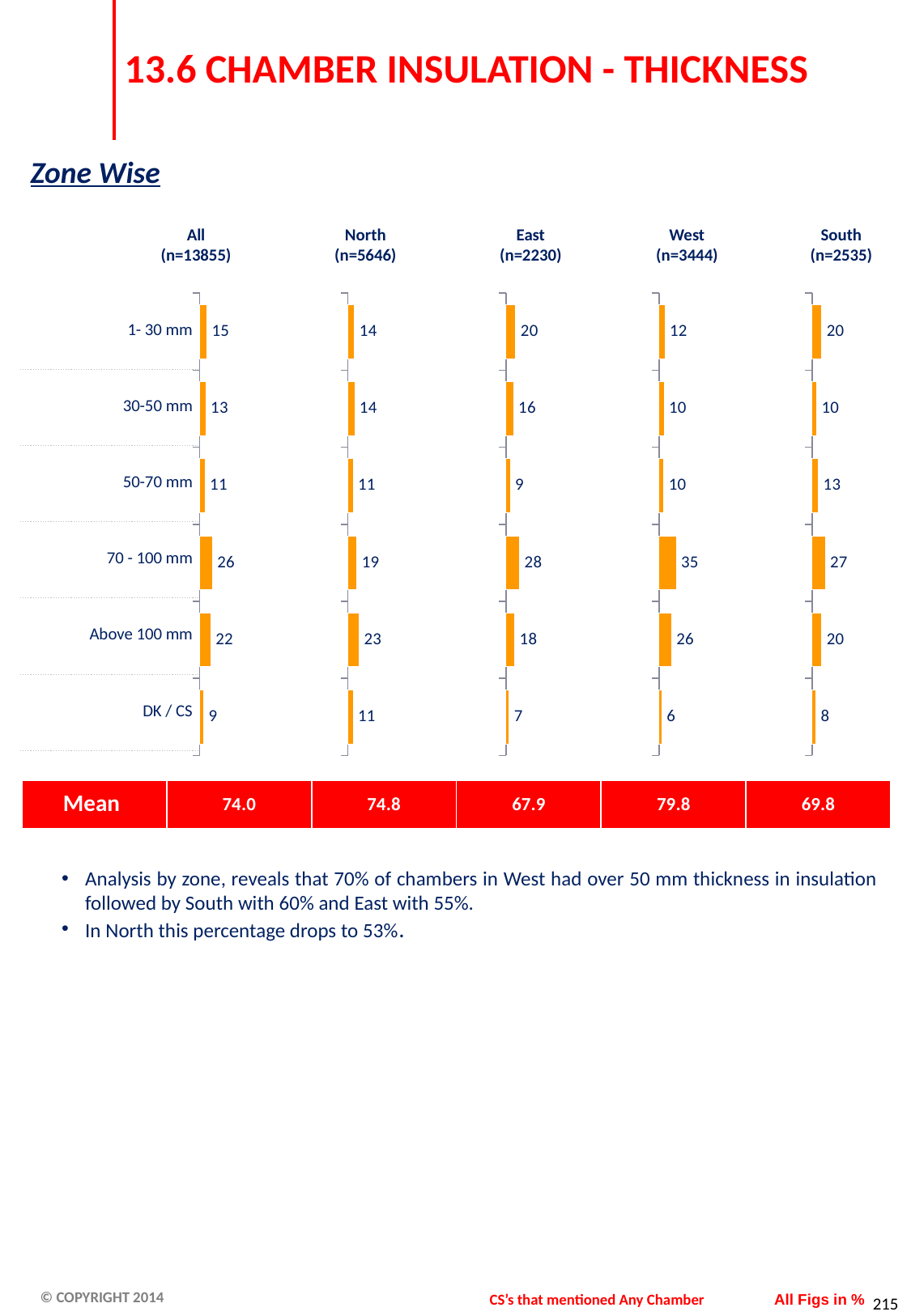
Which zone has the highest Mean value shown in the red row below the charts? West In the South (n=2535) chart, what is the value for 1- 30 mm? 20 How many categories are shown in each of the bar charts on the slide? 6 In the North (n=5646) chart, which is larger: the value for Above 100 mm or the value for 70 - 100 mm? Above 100 mm In the East (n=2230) chart, which category has the highest value? 70 - 100 mm In the East (n=2230) chart, what is the value for DK / CS? 7 What is the Mean value shown for the East zone? 67.9 In the South (n=2535) chart, what is the difference between the values for 70 - 100 mm and 30-50 mm? 17 In the West (n=3444) chart, which category has the lowest value? DK / CS In the All (n=13855) chart, what is the value for Above 100 mm? 22 In the West (n=3444) chart, what is the value for 70 - 100 mm? 35 What kind of chart is used to show the thickness distribution for each zone? Bar chart